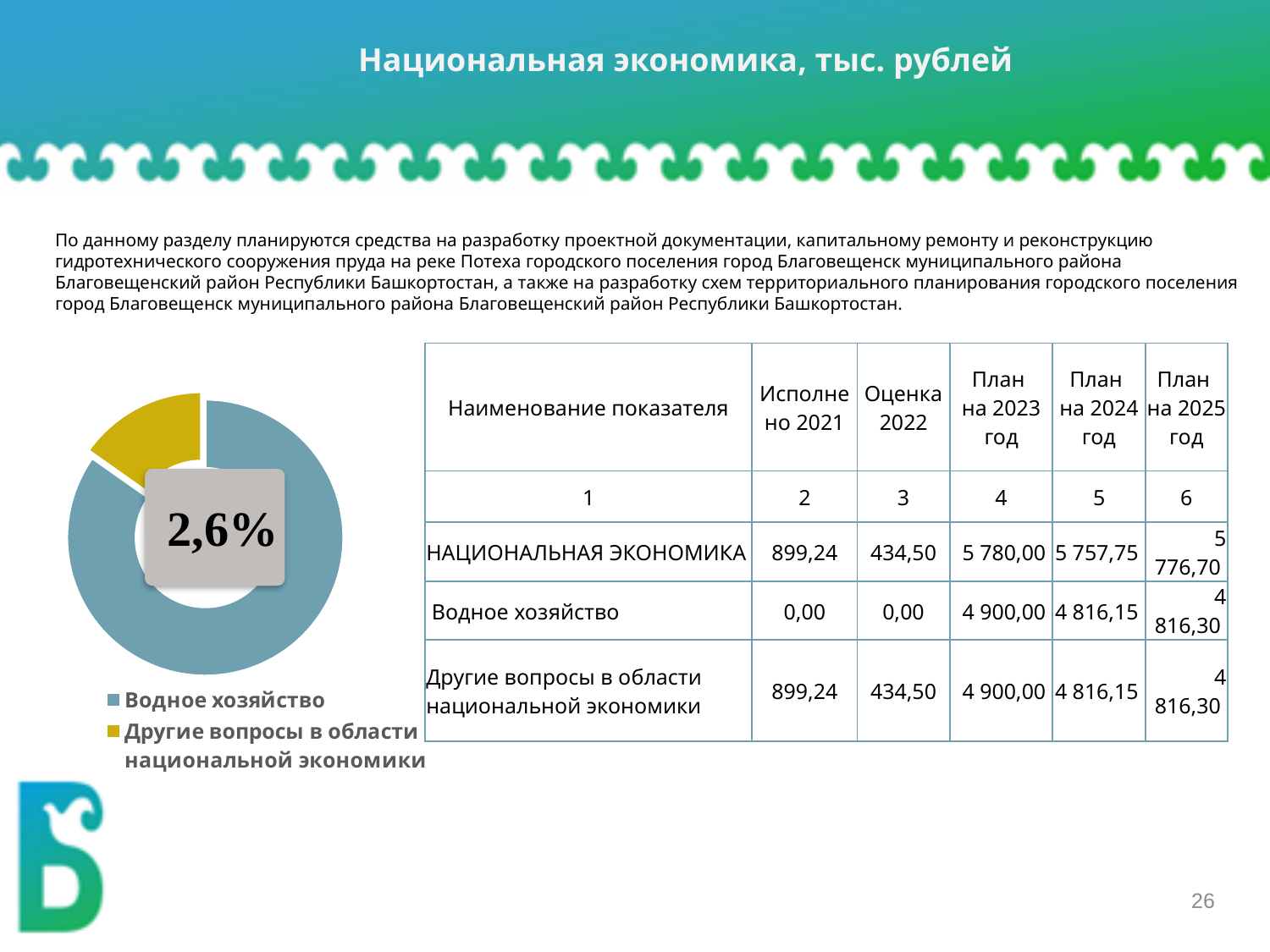
How many entries does the legend of the doughnut chart list? 2 What colour is the Водное хозяйство slice in the doughnut chart? Blue Which category has the largest slice in the doughnut chart? Водное хозяйство What text is displayed in the centre of the doughnut chart? 2,6% Which category has the smallest slice in the doughnut chart? Другие вопросы в области национальной экономики In the doughnut chart, which slice is larger: Водное хозяйство or Другие вопросы в области национальной экономики? Водное хозяйство What kind of chart is shown on the left of the slide? Doughnut (pie) chart How many slices does the doughnut chart have? 2